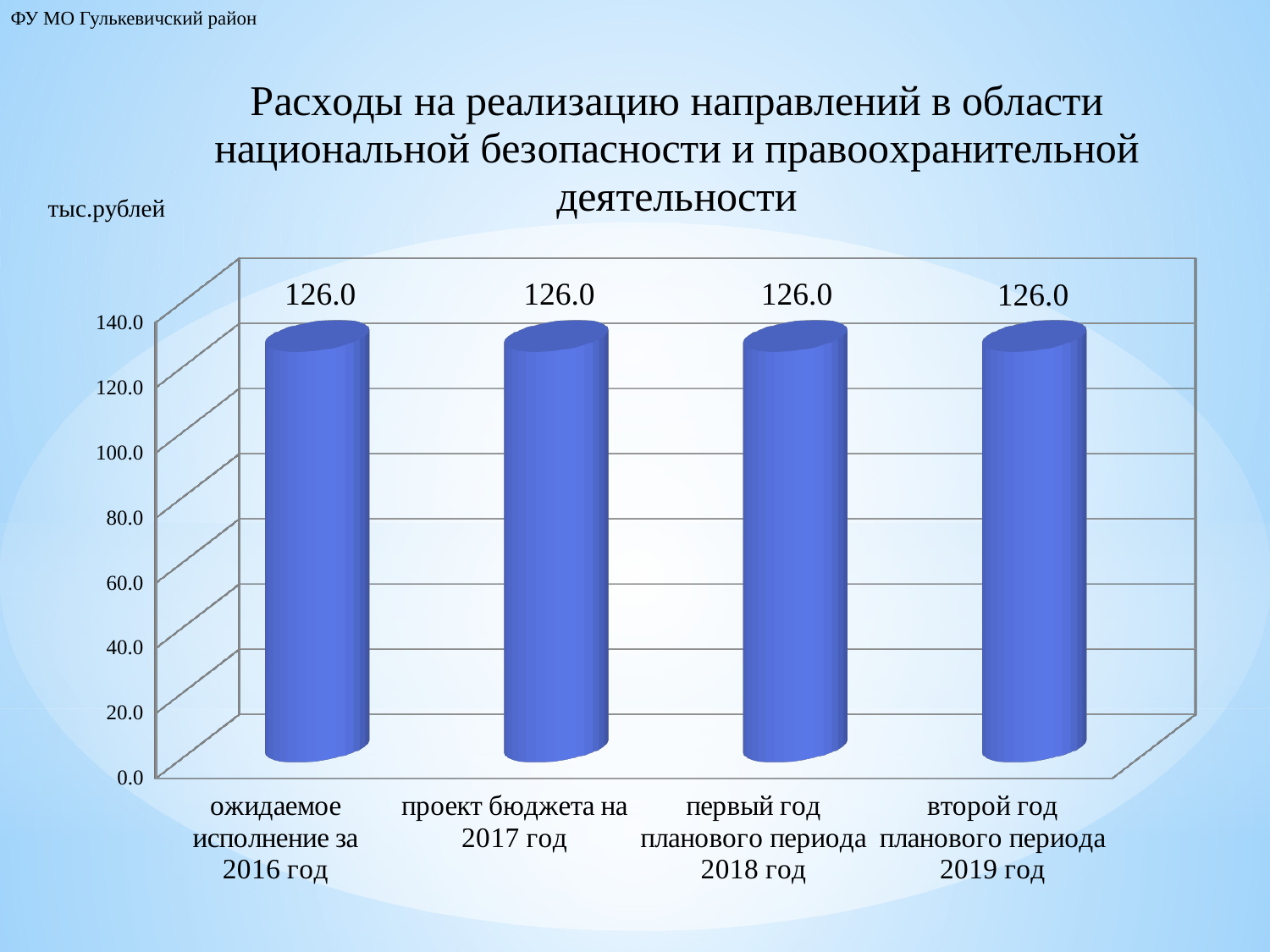
What is the value for "ожидаемое исполнение за 2016 год"? 126.0 What kind of chart is shown on the slide? bar chart What is the value for "первый год планового периода 2018 год"? 126.0 Do the values rise, fall or stay the same from 2016 год to 2019 год? stay the same What is the value for "второй год планового периода 2019 год"? 126.0 How many categories are shown on the chart? 4 What unit of measurement is indicated for the chart values? тыс.рублей Is the value for "второй год планового периода 2019 год" greater or less than 140.0? less What is the value for "проект бюджета на 2017 год"? 126.0 What is the difference between the value for 2019 год and the value for 2016 год? 0.0 Is the value for "проект бюджета на 2017 год" greater or less than 120.0? greater What is the title of the chart? Расходы на реализацию направлений в области национальной безопасности и правоохранительной деятельности